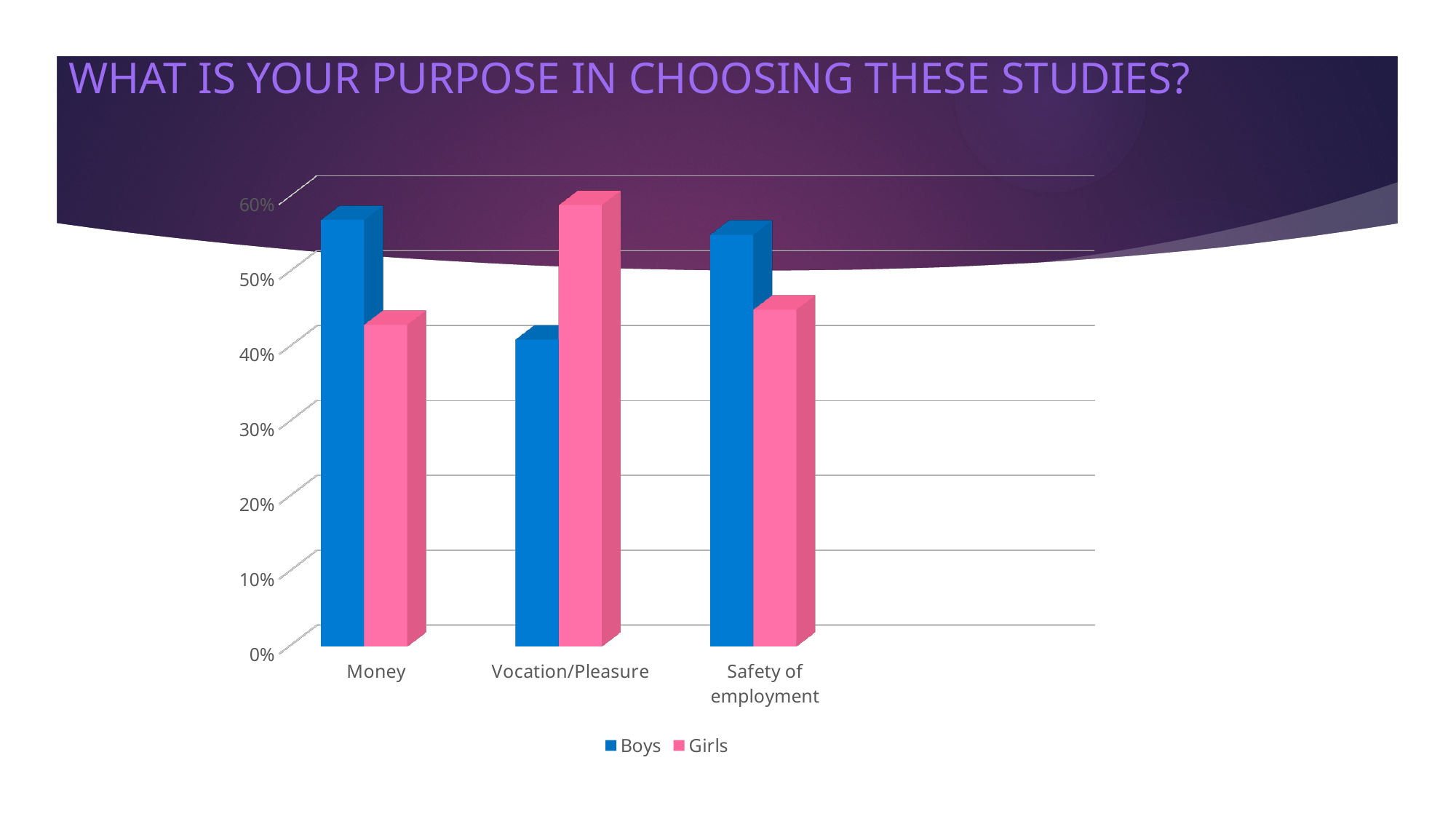
How many categories are shown on the x axis of the chart? 3 What is the title of the chart on the slide? WHAT IS YOUR PURPOSE IN CHOOSING THESE STUDIES? Is the Girls value for Money greater or less than 50%? less For which category is the Girls value the highest? Vocation/Pleasure Which colour represents the Girls series in the chart? pink Is the Boys value for Money greater or less than 50%? greater For which category is the Boys value the lowest? Vocation/Pleasure Is the Boys value for Vocation/Pleasure greater or less than 50%? less What kind of chart is shown on the slide? bar chart For Safety of employment, which is larger, the Boys value or the Girls value? Boys How many series does the chart's legend list? 2